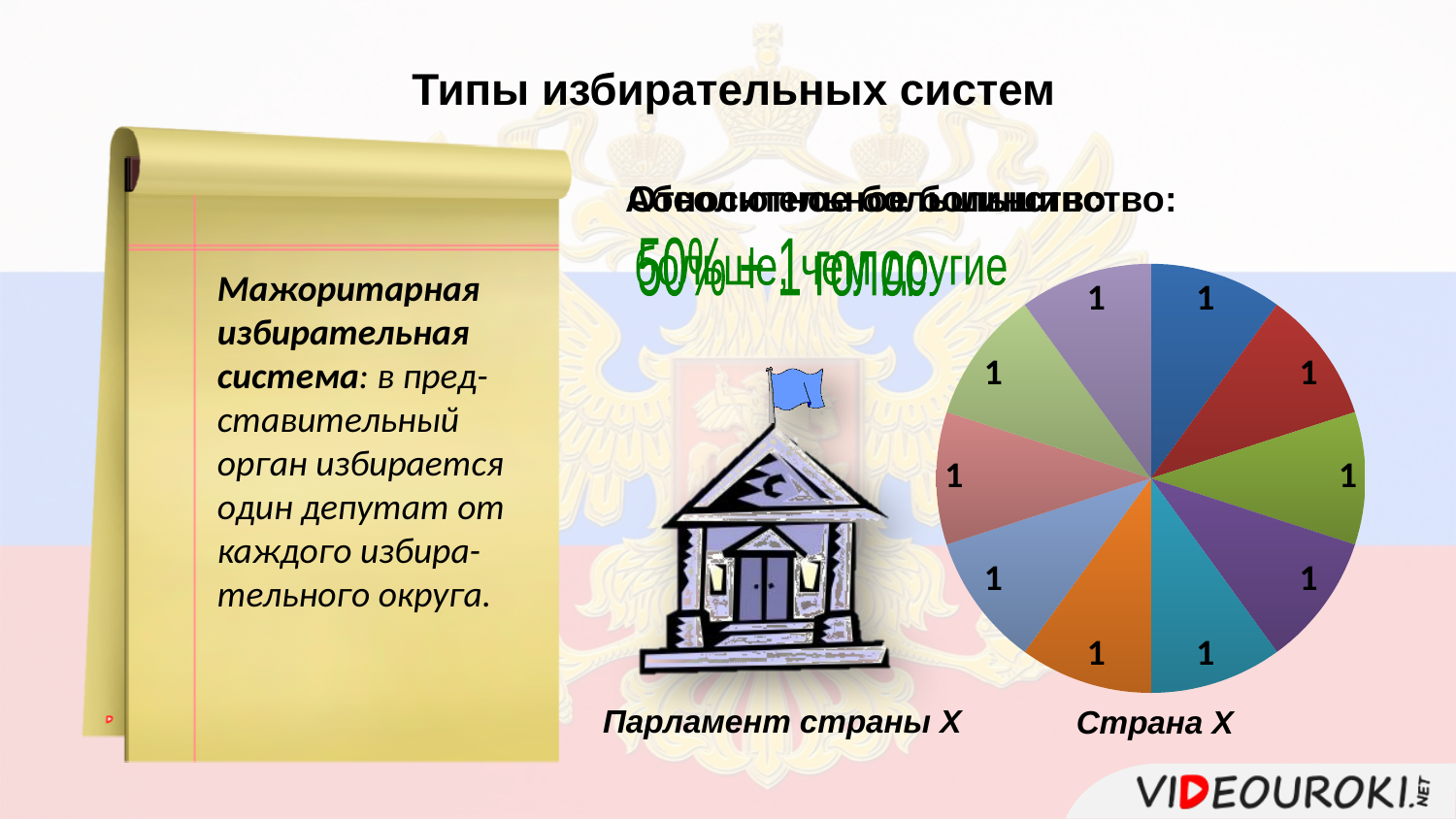
What caption appears directly below the pie chart on the slide? Страна X What value is printed on each slice of the pie chart labelled "Страна X"? 1 What is the difference between the values of any two slices in the pie chart labelled "Страна X"? 0 What kind of chart is shown on the right side of the slide under the heading "Страна X"? pie chart In the pie chart labelled "Страна X", is any slice larger than the others? No, all slices are equal Does the pie chart labelled "Страна X" have a legend? No What is the total of all the slice values in the pie chart labelled "Страна X"? 10 What share of the whole pie does a single slice represent in the pie chart labelled "Страна X"? 10% How many slices does the pie chart labelled "Страна X" have? 10